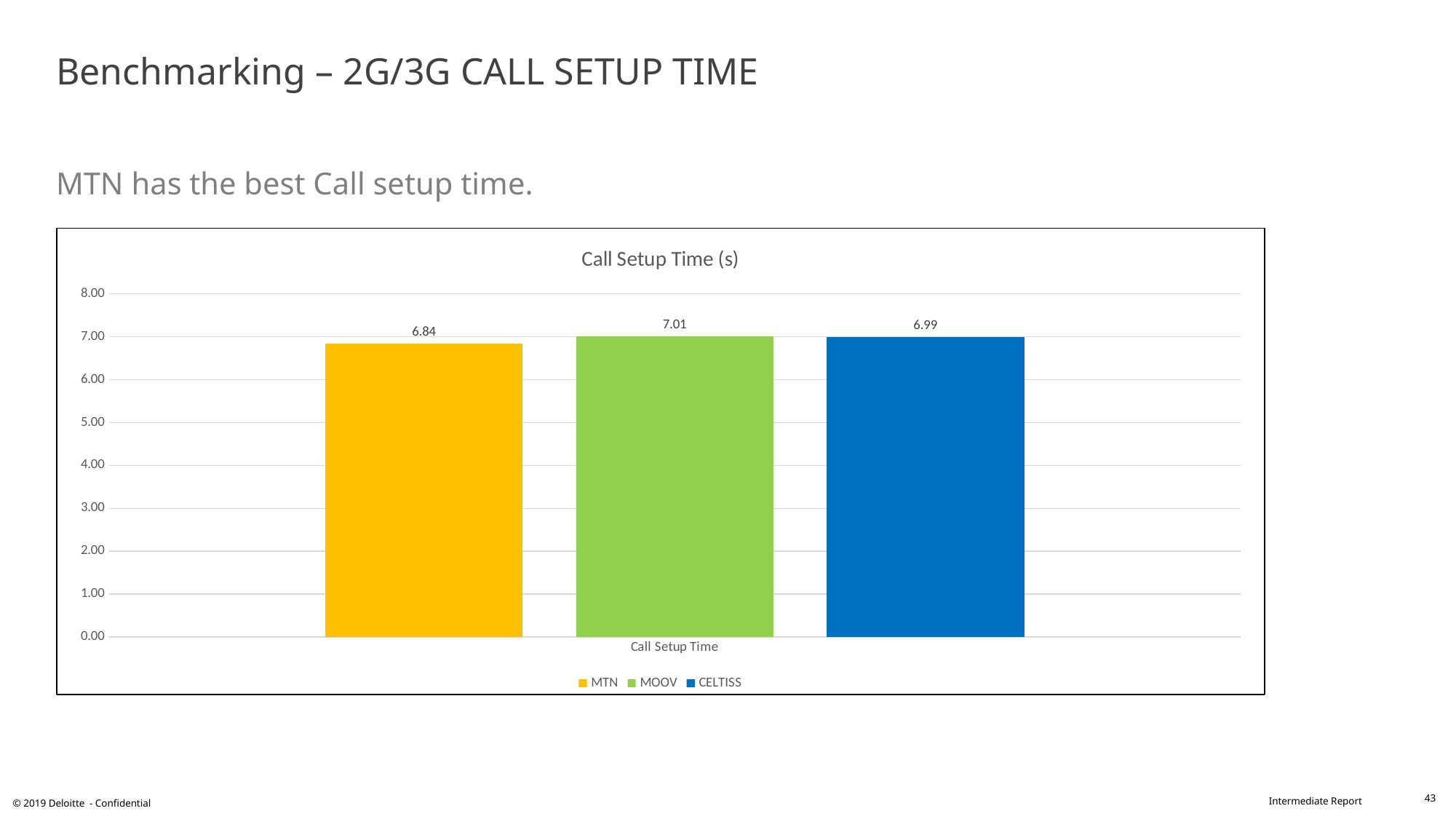
What is the difference between the call setup times of MOOV and MTN? 0.17 Is the call setup time for MTN greater or less than 7.00? less Which operator has the lowest call setup time? MTN How many series does the legend list? 3 Which operator has the highest call setup time? MOOV Which has a larger call setup time, MTN or MOOV? MOOV What is the call setup time for CELTISS? 6.99 What is the title of the chart? Call Setup Time (s) What is the call setup time for MOOV? 7.01 What is the difference between the call setup times of CELTISS and MTN? 0.15 What is the call setup time for MTN? 6.84 What kind of chart is shown on the slide? Bar chart